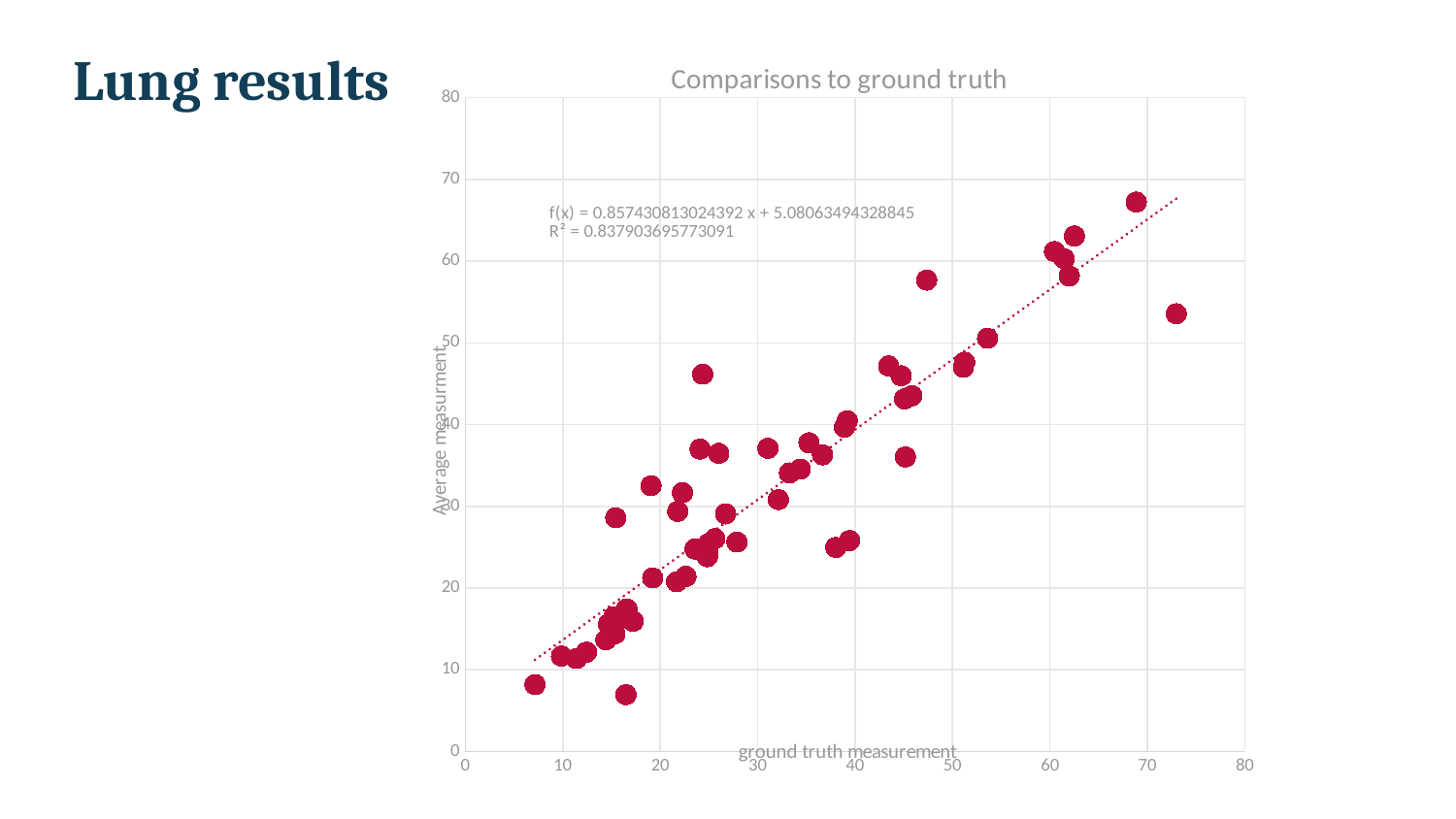
What is the title of the chart? Comparisons to ground truth Is the average measurement of the highest plotted point greater or less than 60? greater Is the average measurement of the rightmost point (ground truth just above 70) greater or less than 60? less Do the average measurement values generally rise or fall as the ground truth measurement increases? Rise Which point has the higher average measurement: the rightmost point or the point just to its left near ground truth 69? The point near ground truth 69 Is the average measurement of the leftmost point (ground truth below 10) greater or less than 10? less What kind of chart is shown on the slide? Scatter chart What is the label of the x axis of the chart? ground truth measurement What R² value is printed on the chart? 0.837903695773091 What is the trendline equation printed on the chart? f(x) = 0.857430813024392 x + 5.08063494328845 What is the maximum value shown on the y axis? 80